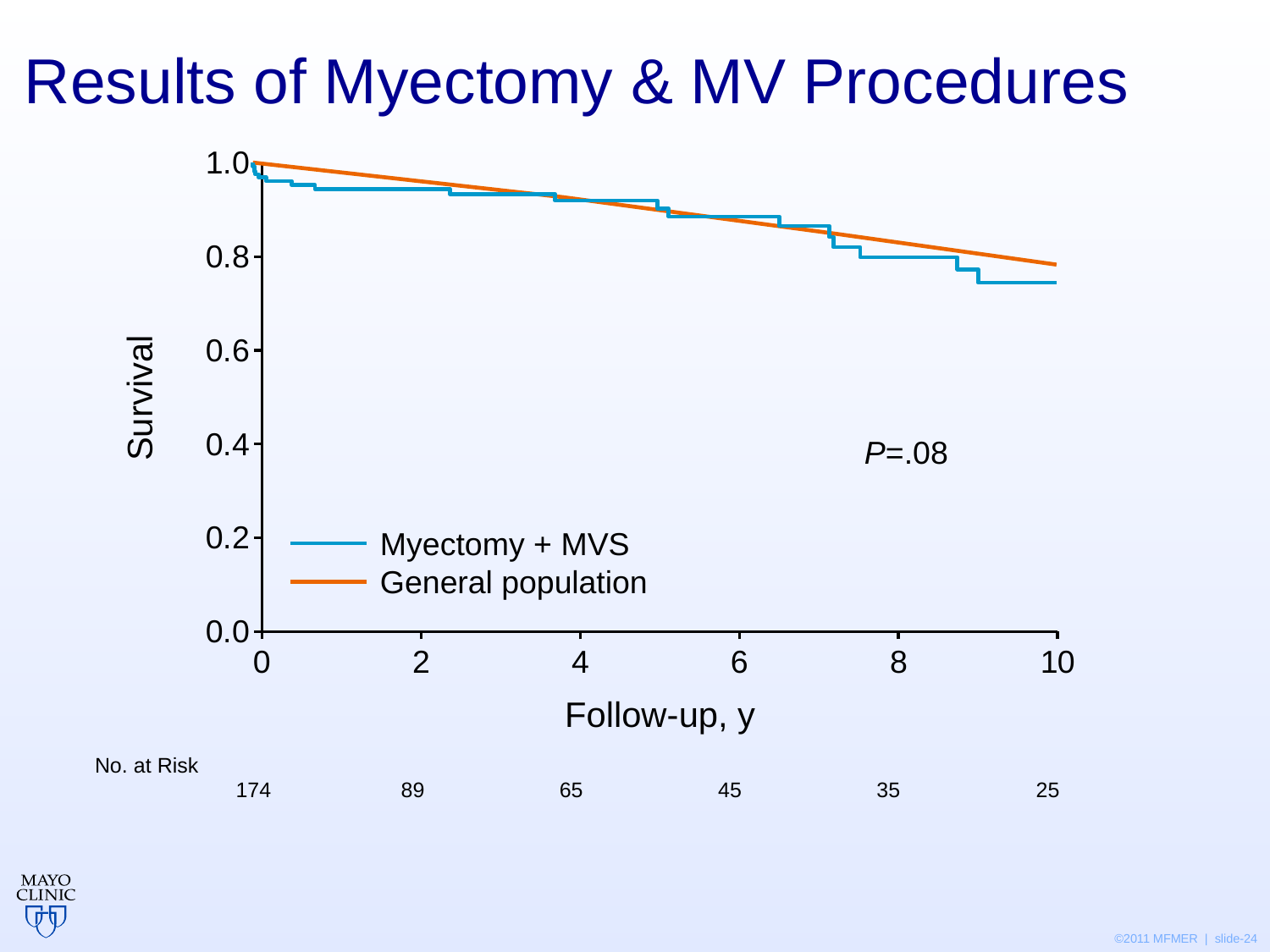
Is the survival for Myectomy + MVS at 10 years greater or less than 0.8? less What is the number at risk at 4 years of follow-up? 65 Is the survival for Myectomy + MVS at 2 years greater or less than 0.8? greater What are the two series named in the legend? Myectomy + MVS and General population What P value is printed on the chart? P=.08 How many series does the legend list? 2 What is the number at risk at 0 years of follow-up? 174 What is the number at risk at 10 years of follow-up? 25 What kind of chart is shown on the slide? line chart What is the difference between the number at risk at 0 years and at 2 years? 85 How many 'No. at Risk' values are printed below the x axis? 6 Do the survival curves rise or fall as follow-up time increases? fall